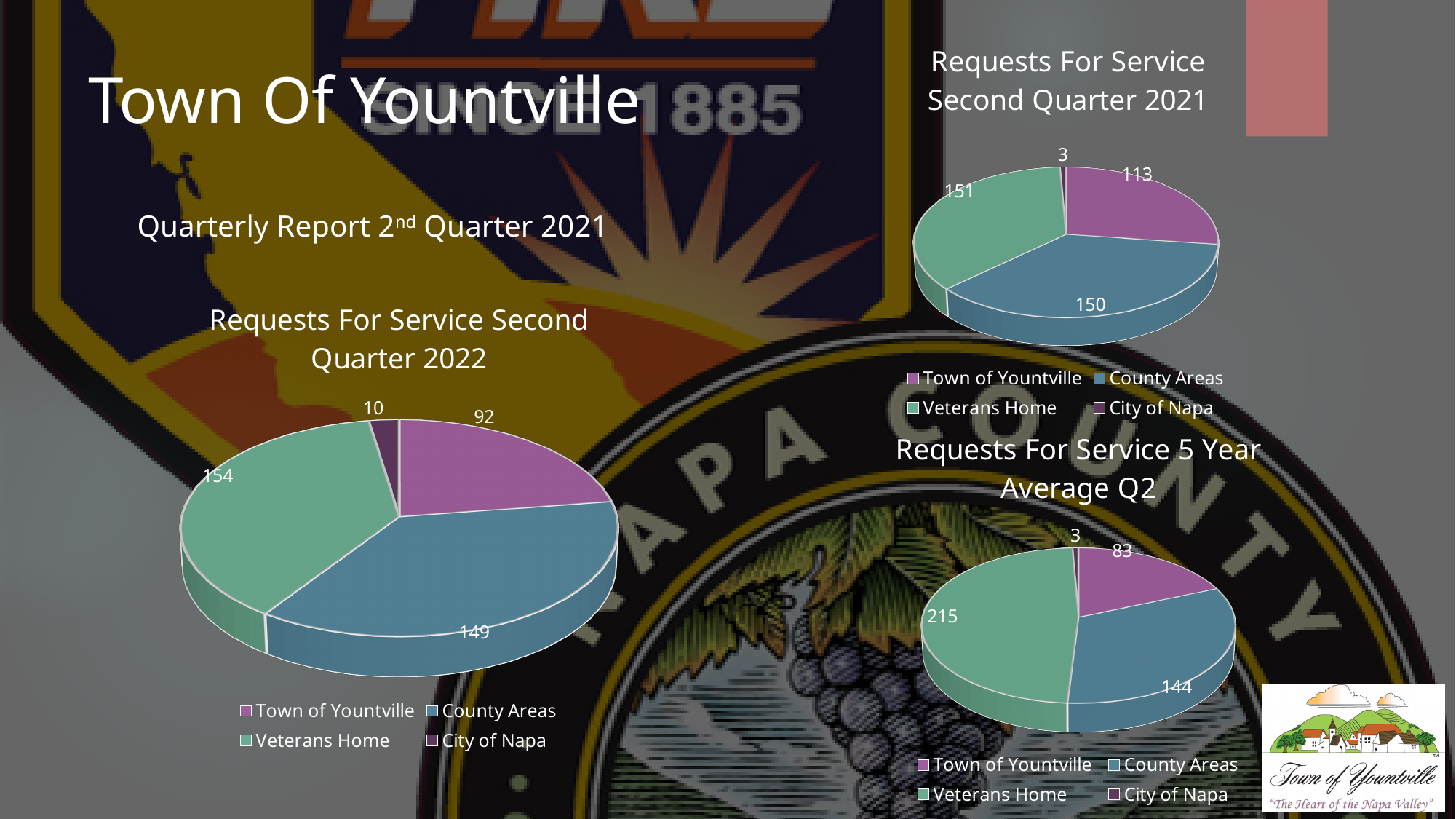
In the Requests For Service 5 Year Average Q2 chart, which is larger, Town of Yountville or County Areas? County Areas In the Requests For Service 5 Year Average Q2 chart, what is the value for County Areas? 144 What type of chart is the Requests For Service 5 Year Average Q2 chart? Pie chart In the Requests For Service 5 Year Average Q2 chart, which category has the highest value? Veterans Home In the Requests For Service Second Quarter 2022 chart, what is the difference between Veterans Home and Town of Yountville? 62 In the Requests For Service Second Quarter 2021 chart, what is the total of all four categories? 417 In the Requests For Service Second Quarter 2022 chart, which category has the lowest value? City of Napa In the Requests For Service Second Quarter 2021 chart, what is the value for Town of Yountville? 113 How many categories does the Requests For Service Second Quarter 2022 chart show? 4 In the Requests For Service Second Quarter 2021 chart, what is the value for City of Napa? 3 In the Requests For Service Second Quarter 2022 chart, what is the value for County Areas? 149 In the Requests For Service 5 Year Average Q2 chart, what is the difference between Veterans Home and County Areas? 71